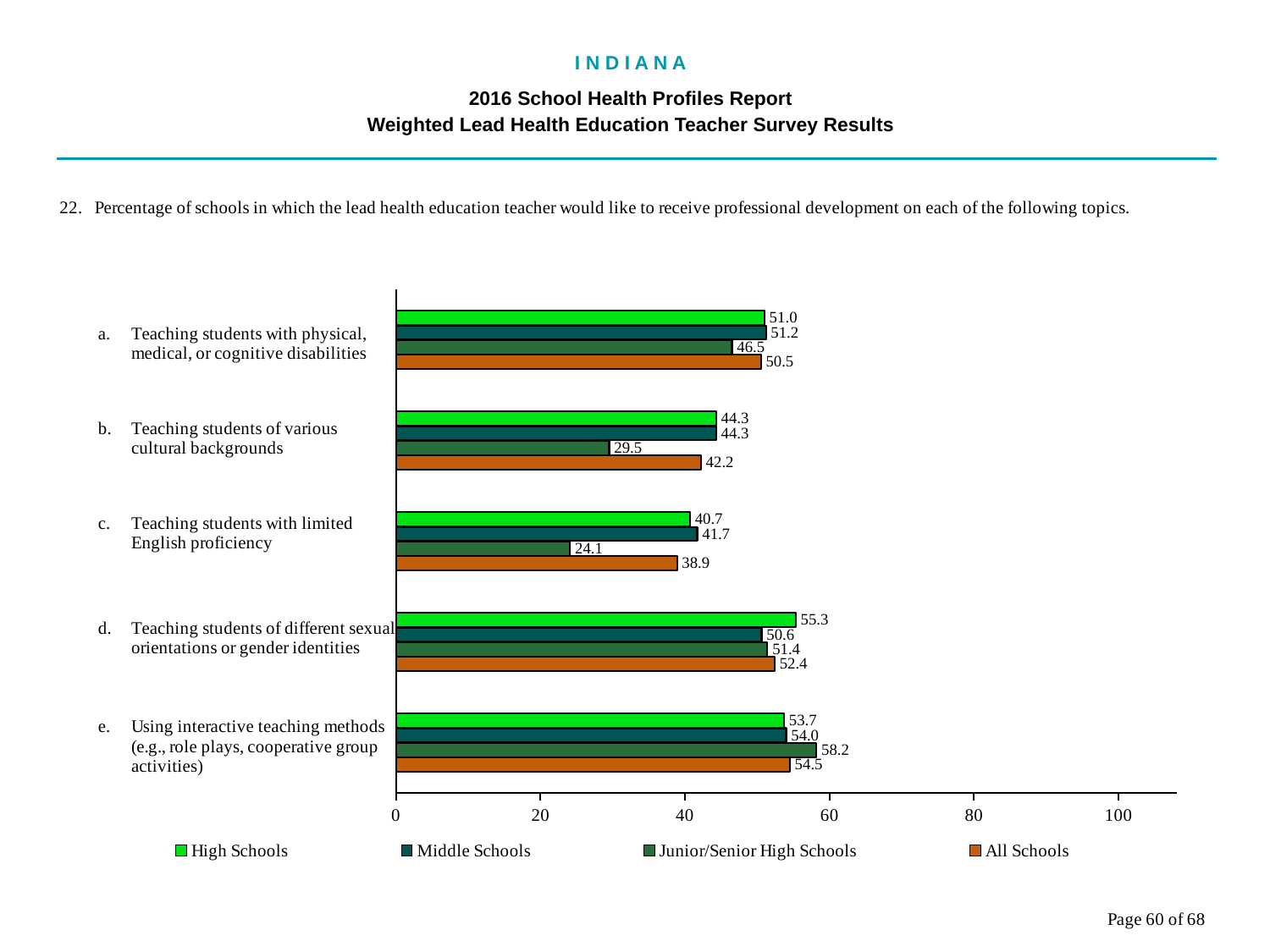
How many series does the legend list? 4 How many topics are shown in the chart? 5 Which topic has the lowest Junior/Senior High Schools value? Teaching students with limited English proficiency What kind of chart is shown on the slide? bar chart What is the Middle Schools value for using interactive teaching methods? 54.0 What is the High Schools value for teaching students of different sexual orientations or gender identities? 55.3 What is the All Schools value for teaching students of various cultural backgrounds? 42.2 What is the difference between the High Schools and Junior/Senior High Schools values for teaching students of various cultural backgrounds? 14.8 Is the All Schools value for teaching students with limited English proficiency greater or less than 40? less What is the Junior/Senior High Schools value for teaching students with limited English proficiency? 24.1 Which topic has the highest All Schools value? Using interactive teaching methods (e.g., role plays, cooperative group activities) Which is larger for using interactive teaching methods: the Junior/Senior High Schools value or the High Schools value? Junior/Senior High Schools